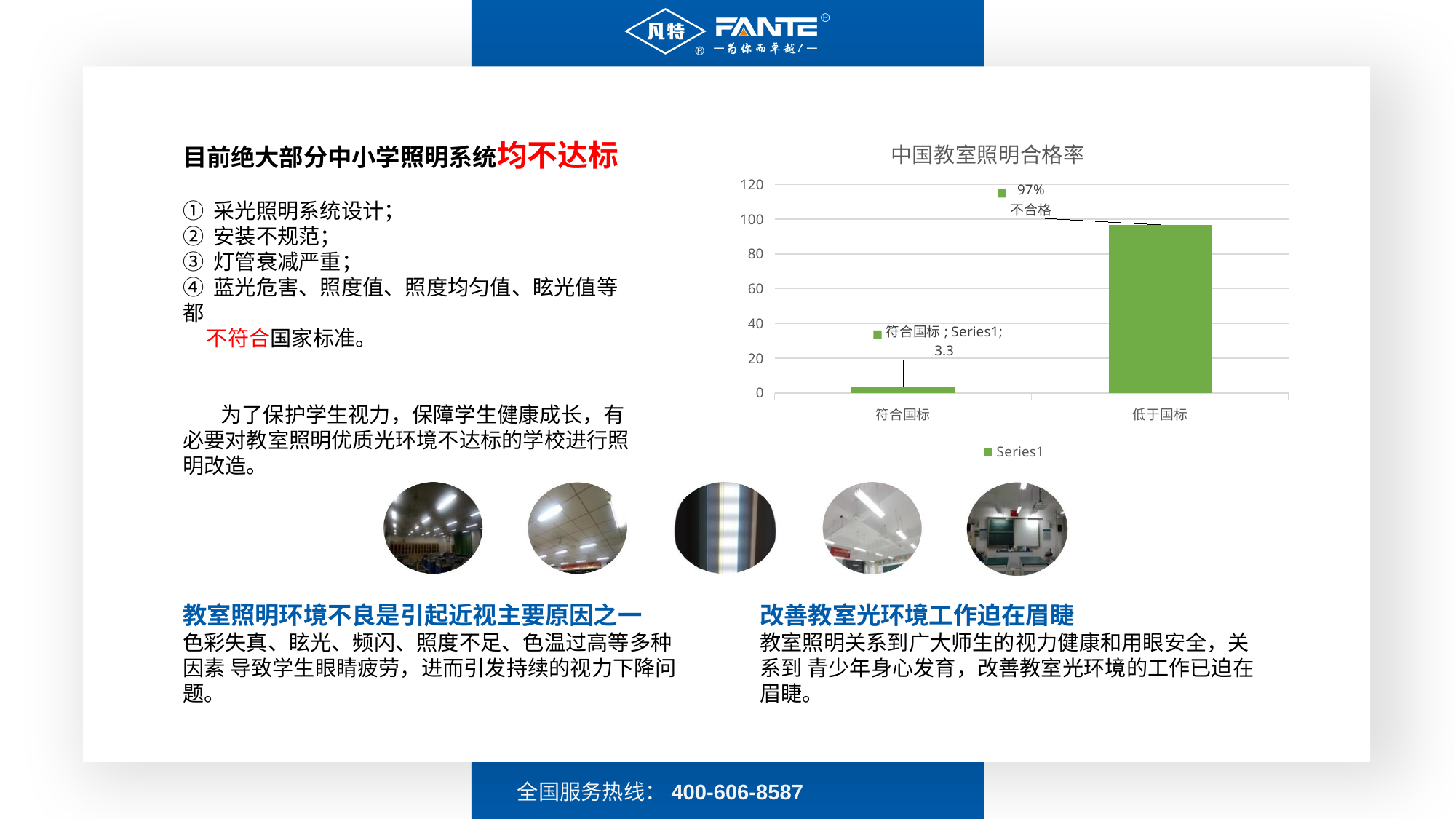
Is the value for 符合国标 greater or less than 20? less How many categories are shown on the x axis of the chart? 2 What series name is shown in the chart legend? Series1 What type of chart is shown on the slide? bar chart What is the value shown for 符合国标 in the chart? 3.3 Which category has the highest bar in the chart? 低于国标 How many series does the chart legend list? 1 Which category has the lowest bar in the chart? 符合国标 Is the value for 低于国标 greater or less than 80? greater Which is larger, the bar for 符合国标 or the bar for 低于国标? 低于国标 What is the title of the chart? 中国教室照明合格率 What data label is shown above the 低于国标 bar? 97% 不合格